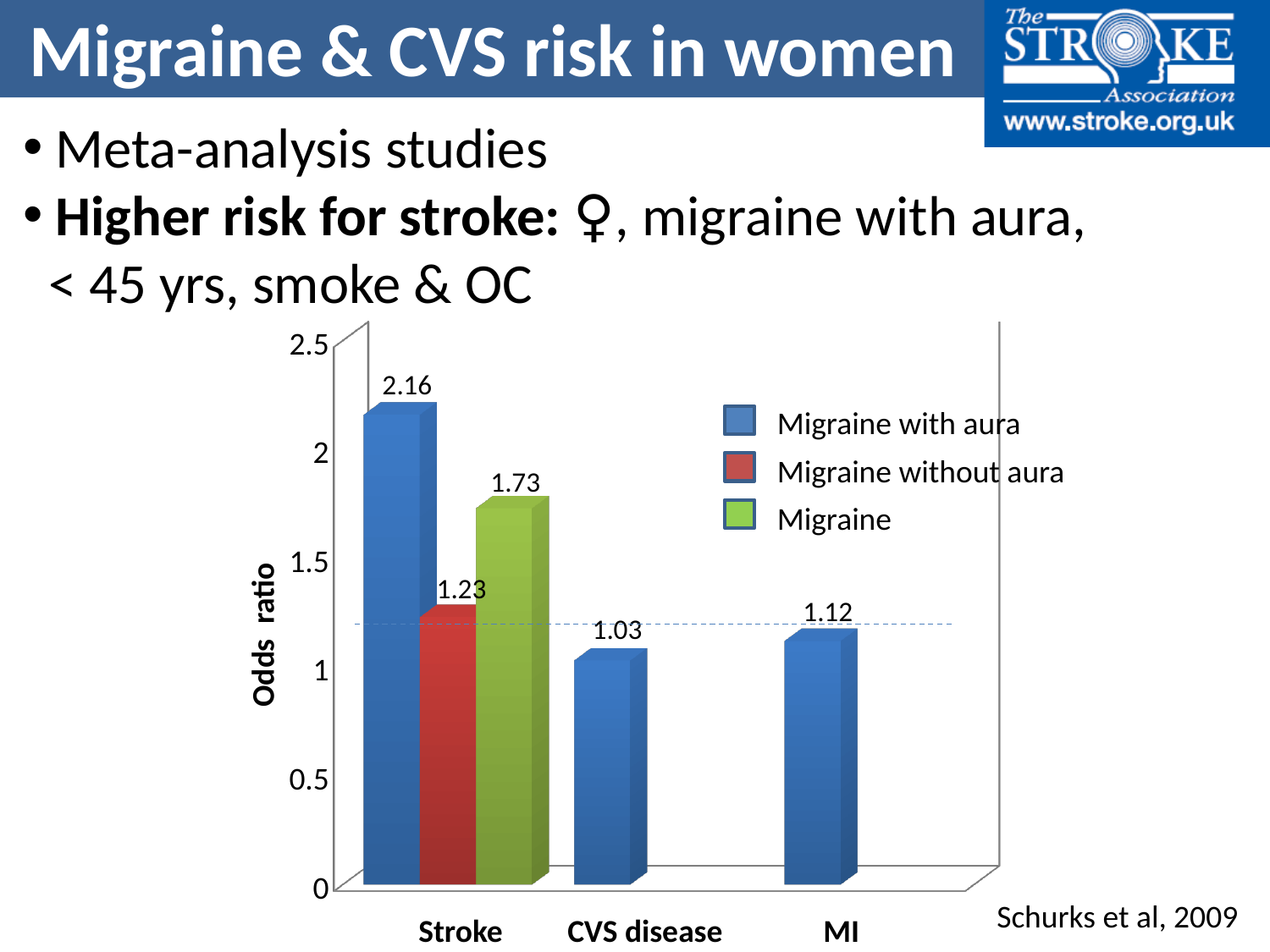
Which category has the highest odds ratio for Migraine with aura? Stroke What is the odds ratio for Migraine with aura for MI? 1.12 Which is larger for Stroke: the odds ratio for Migraine or for Migraine without aura? Migraine Which category has the lowest odds ratio for Migraine with aura? CVS disease What is the odds ratio for Migraine with aura for Stroke? 2.16 What is the label of the vertical axis of the chart? Odds ratio What is the odds ratio for Migraine for Stroke? 1.73 How many series does the legend list? 3 What is the odds ratio for Migraine without aura for Stroke? 1.23 What kind of chart is shown on the slide? Bar chart What is the difference between the Migraine with aura and Migraine without aura odds ratios for Stroke? 0.93 What is the odds ratio for Migraine with aura for CVS disease? 1.03